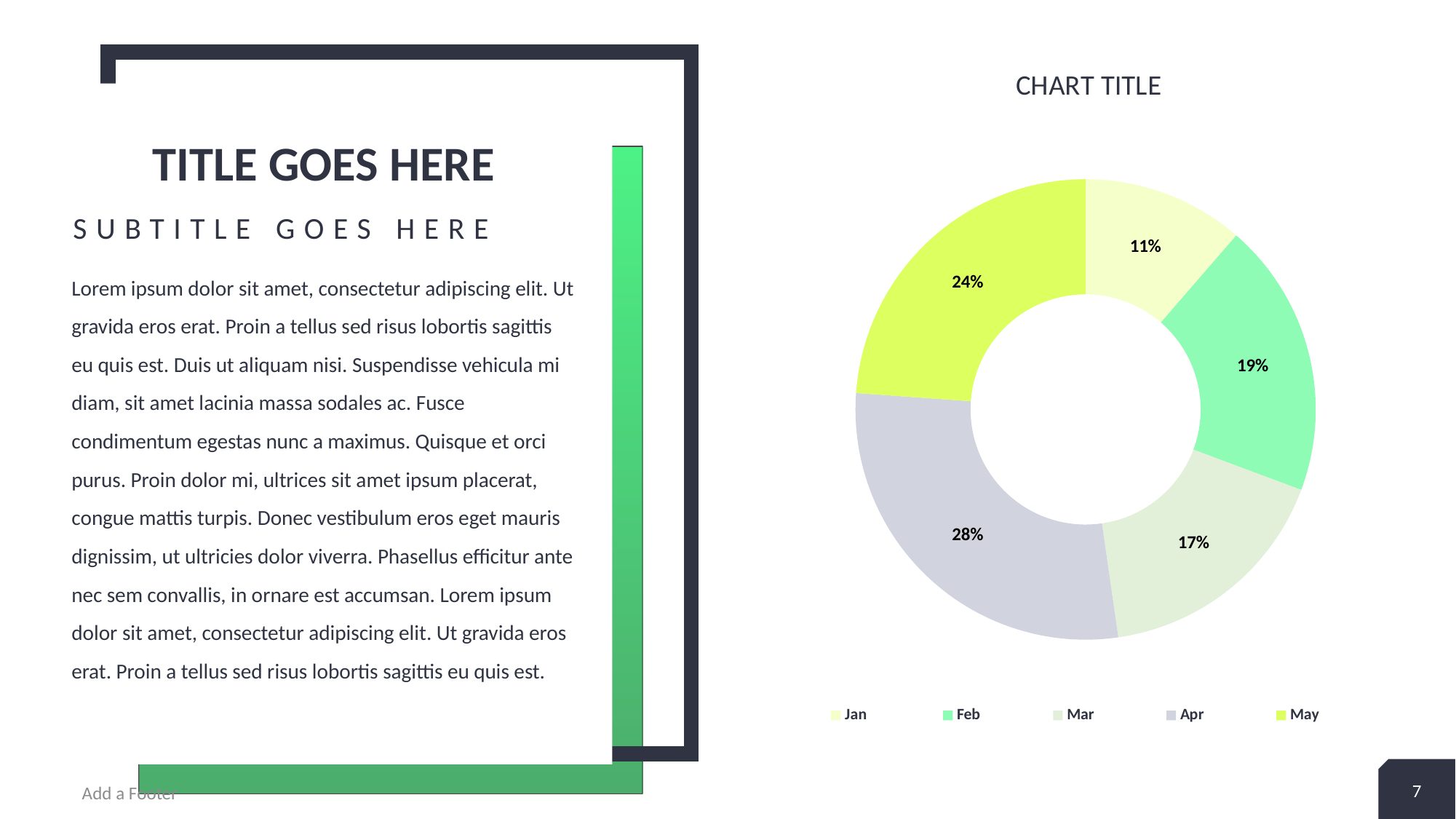
Which category has the largest share of the chart? Apr What is the value shown for May? 24% Which legend entry is listed last? May How many categories does the chart show? 5 What is the value shown for Jan? 11% What is the value shown for Mar? 17% What is the value shown for Apr? 28% What kind of chart is shown on the slide? Doughnut chart Which is larger, the value for Feb or the value for Mar? Feb Which category has the smallest share of the chart? Jan What is the difference between the values for Apr and Jan? 17% What is the title of the chart? CHART TITLE